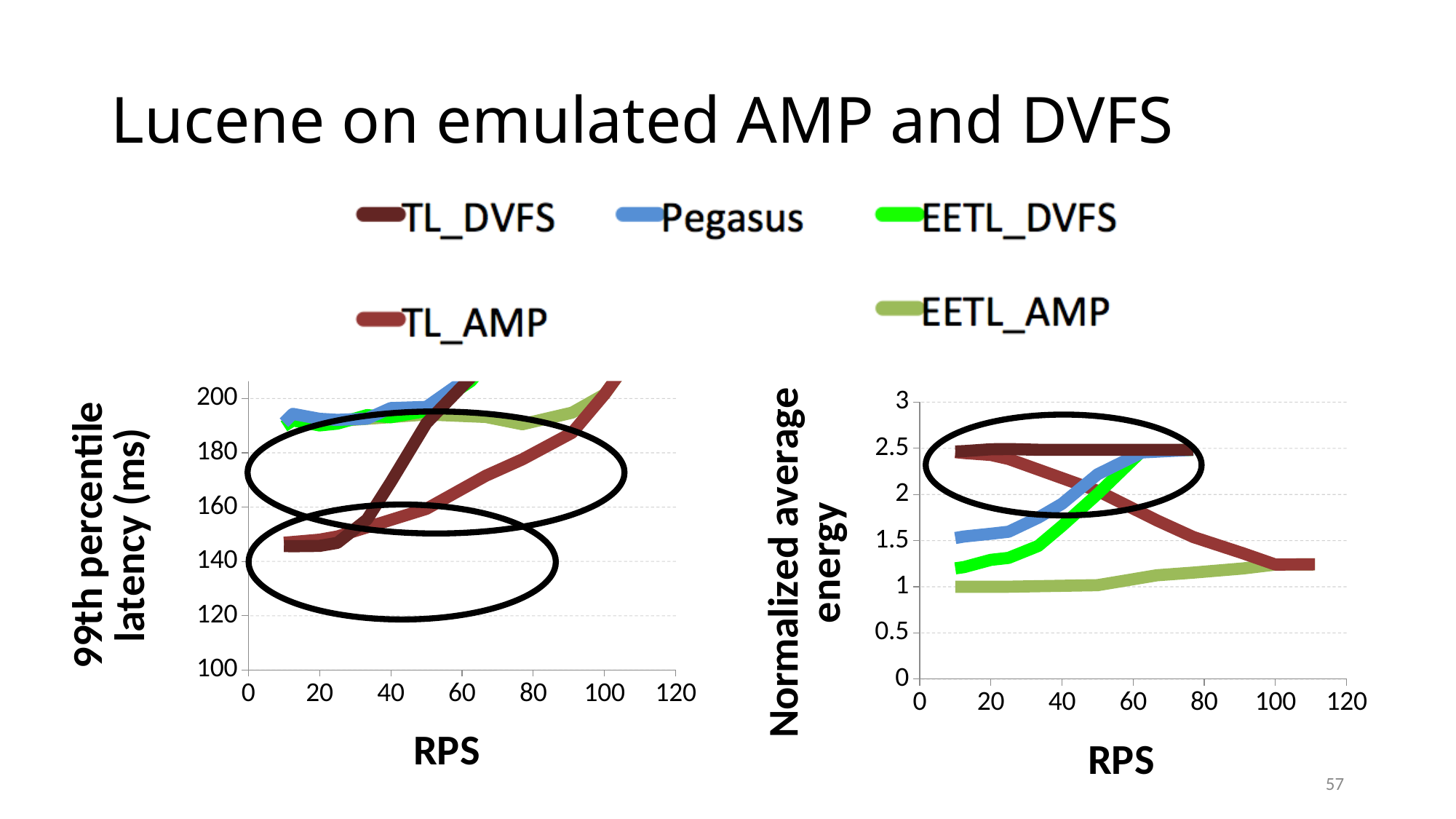
In the right chart (Normalized average energy), is the value for TL_AMP at 100 RPS greater or less than 1.5? less In the right chart (Normalized average energy), does the TL_AMP line rise or fall as RPS increases? fall What kind of chart is the left chart showing 99th percentile latency? line chart How many series does the legend list? 5 What is the x-axis label of the right chart? RPS In the left chart (99th percentile latency), is the value for TL_DVFS at 10 RPS greater or less than 160? less In the left chart (99th percentile latency), does the TL_DVFS line rise or fall as RPS increases? rise In the right chart (Normalized average energy), at 20 RPS, which is larger: TL_DVFS or EETL_AMP? TL_DVFS In the right chart (Normalized average energy), is the value for EETL_AMP at 20 RPS greater or less than 1.5? less In the right chart (Normalized average energy), does the EETL_DVFS line rise or fall as RPS increases? rise